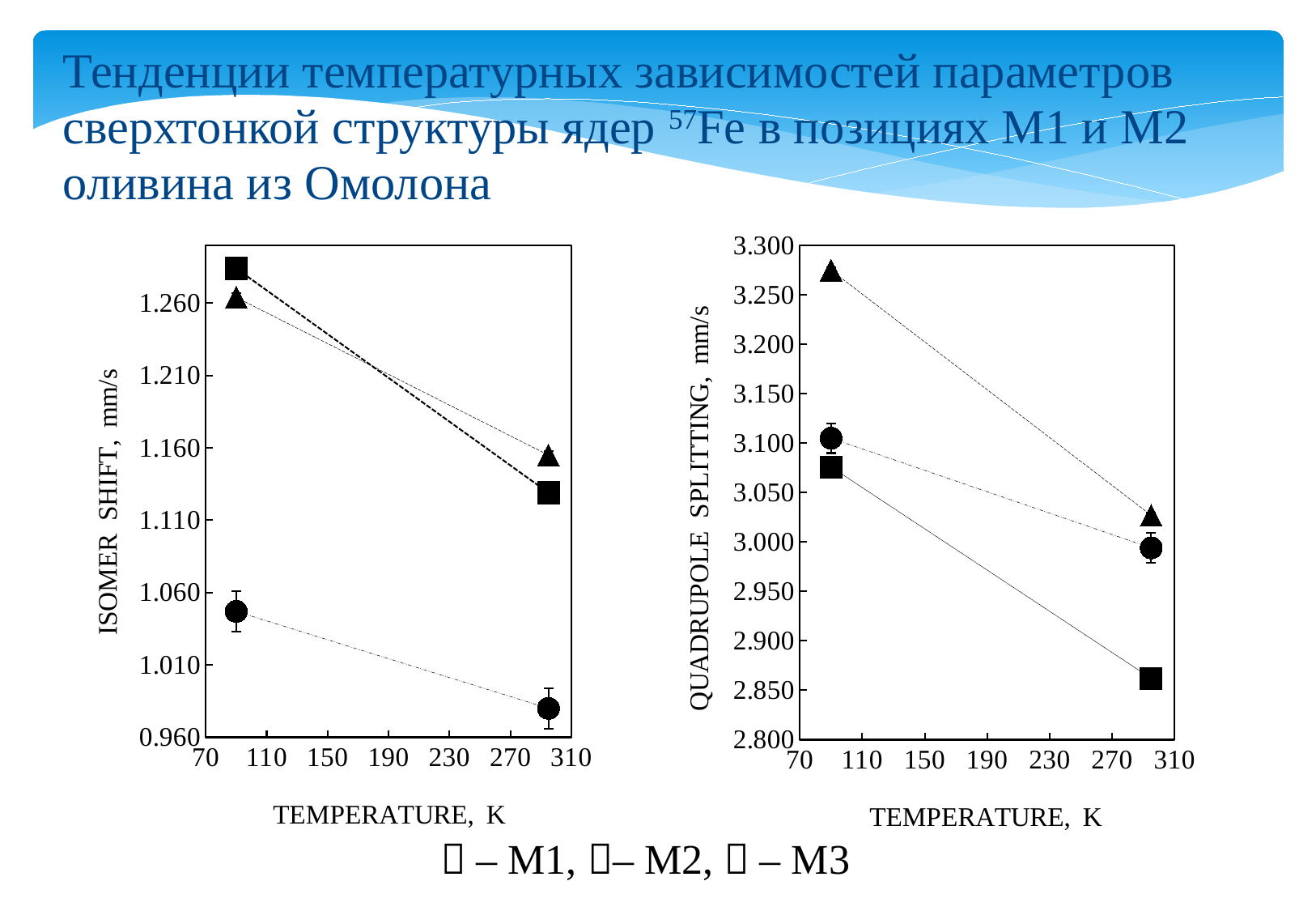
In the left chart (ISOMER SHIFT), is the circle marker's value at the higher temperature greater or less than 1.010? less In the left chart (ISOMER SHIFT), is the square marker's value at the higher temperature greater or less than 1.110? greater How many data points does each marker series have in the left chart (ISOMER SHIFT)? 2 What kind of chart is the left chart (ISOMER SHIFT)? Scatter (line) chart with markers In the left chart (ISOMER SHIFT), is the square marker's value at the lower temperature greater or less than 1.260? greater In the left chart (ISOMER SHIFT), do the values rise or fall as temperature increases? Fall In the right chart (QUADRUPOLE SPLITTING), which marker series has the lowest value at the higher temperature? Square In the right chart (QUADRUPOLE SPLITTING), do the values rise or fall as temperature increases? Fall In the right chart (QUADRUPOLE SPLITTING), which marker series has the highest value at the lower temperature? Triangle In the left chart (ISOMER SHIFT), at the higher temperature, which is larger: the triangle marker's value or the square marker's value? Triangle